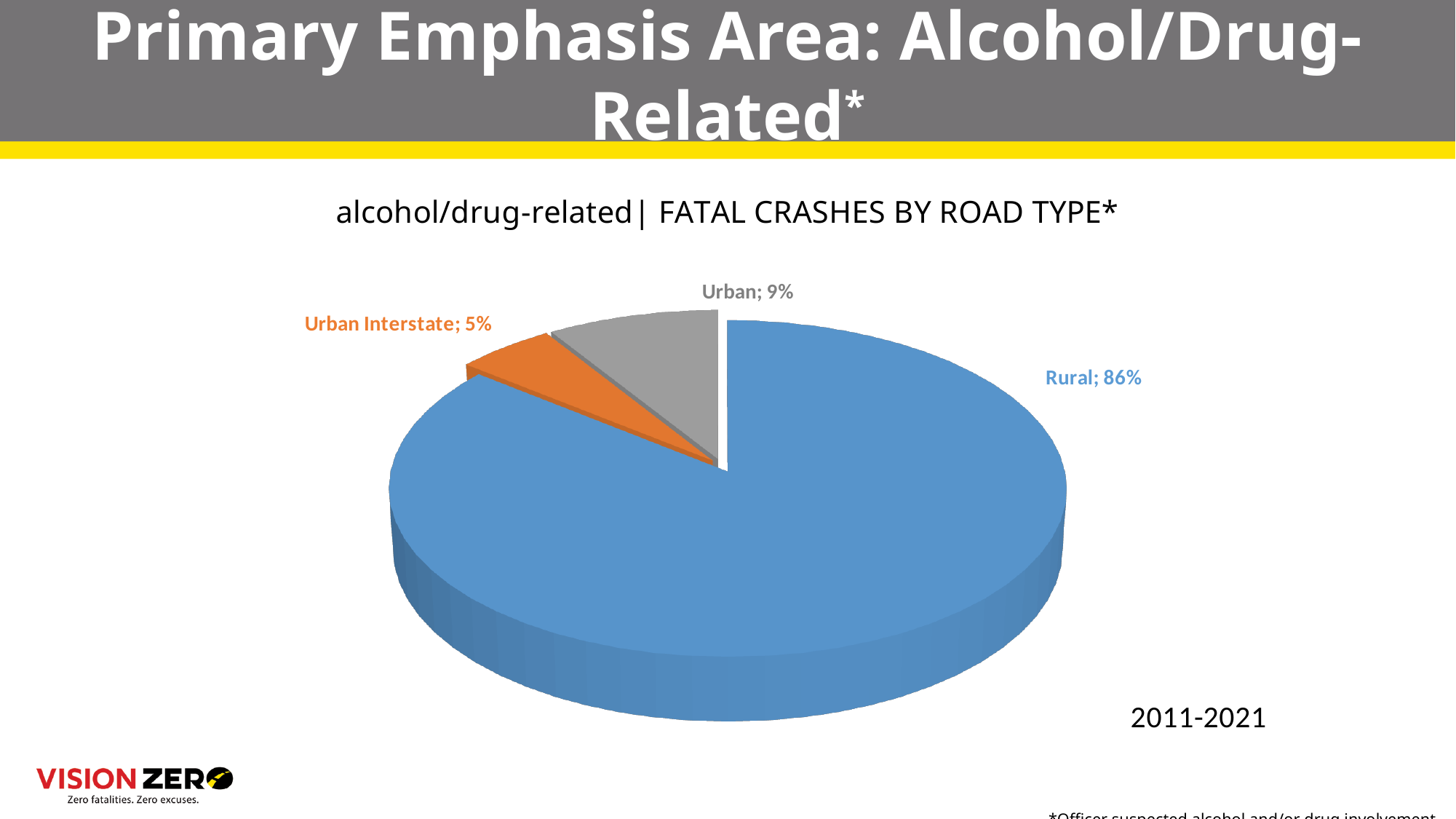
What is the title of the chart? alcohol/drug-related | FATAL CRASHES BY ROAD TYPE* What share of alcohol/drug-related fatal crashes occurred on Urban Interstate roads? 5% What share of alcohol/drug-related fatal crashes occurred on Urban roads? 9% What kind of chart is shown on the slide? Pie chart Which road type has the smallest share of alcohol/drug-related fatal crashes? Urban Interstate What is the difference in percentage points between the Rural share and the Urban share? 77 What share of alcohol/drug-related fatal crashes occurred on Rural roads? 86% How many road type categories are shown in the pie chart? 3 Which road type has the largest share of alcohol/drug-related fatal crashes? Rural Which has a larger share of alcohol/drug-related fatal crashes, Urban or Urban Interstate? Urban What is the difference in percentage points between the Urban share and the Urban Interstate share? 4 What time period does the chart cover? 2011-2021